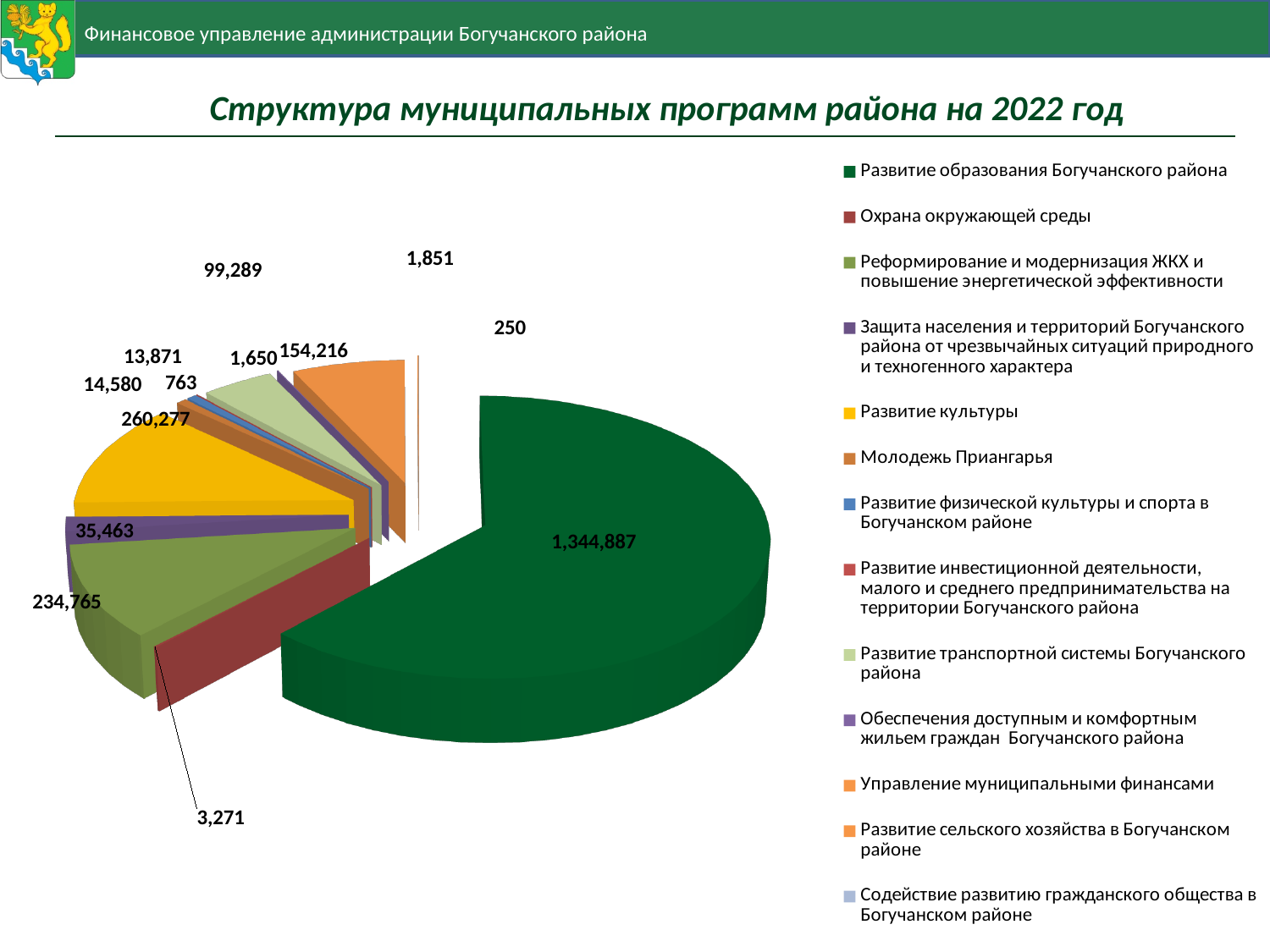
What is the value for «Развитие транспортной системы Богучанского района»? 99,289 What is the value for «Развитие культуры»? 260,277 What is the difference between the values for «Развитие культуры» and «Реформирование и модернизация ЖКХ и повышение энергетической эффективности»? 25,512 Which program has the smallest value in the chart? Содействие развитию гражданского общества в Богучанском районе How many programs (categories) does the legend list? 13 What is the value for «Реформирование и модернизация ЖКХ и повышение энергетической эффективности»? 234,765 Which program has the largest slice of the pie? Развитие образования Богучанского района What is the value for «Развитие образования Богучанского района»? 1,344,887 What kind of chart is shown on the slide? Pie chart What is the value for «Охрана окружающей среды»? 3,271 What is the value for «Управление муниципальными финансами»? 154,216 What is the title of the chart? Структура муниципальных программ района на 2022 год